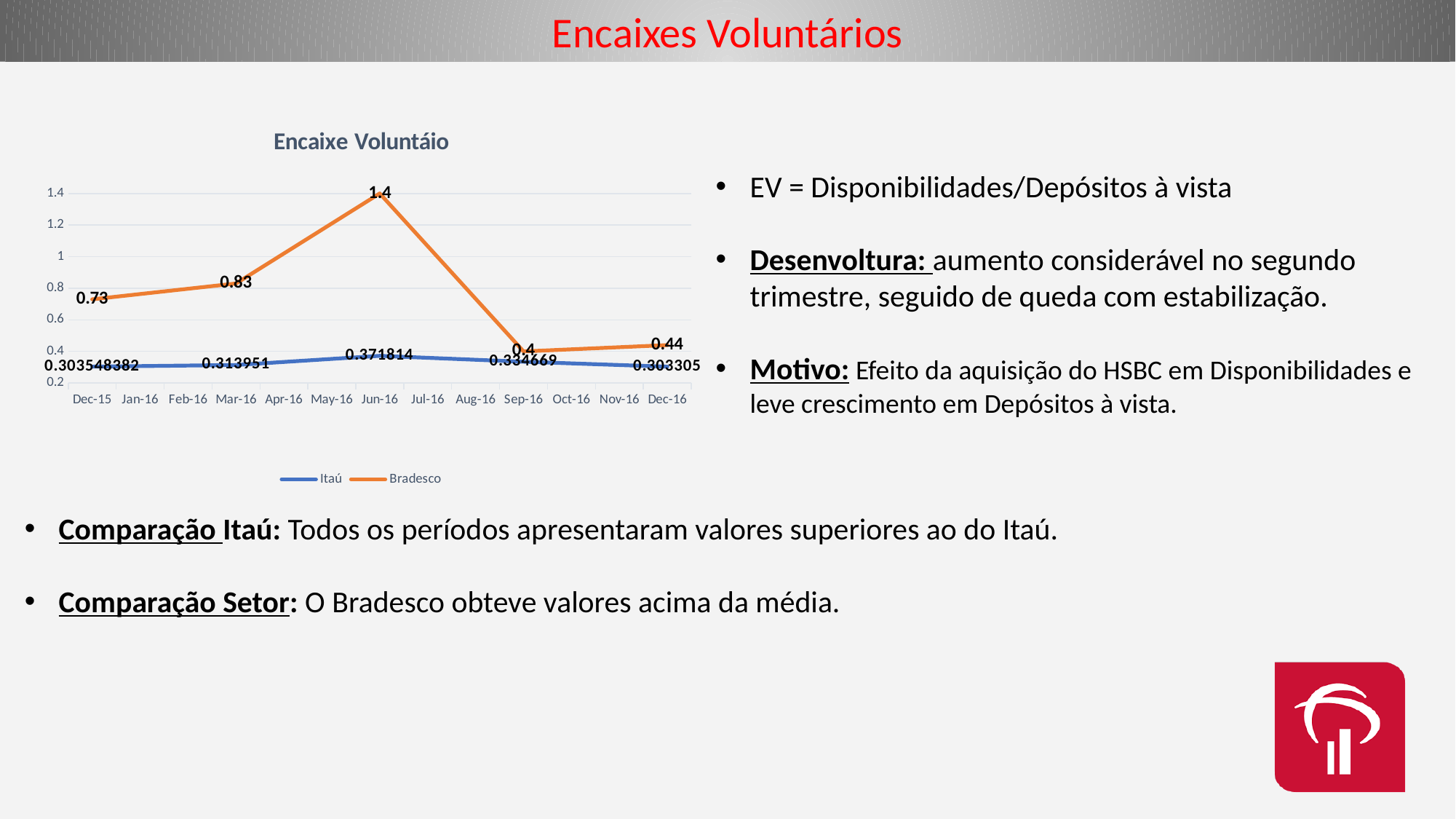
What is the value for Itaú in Jun-16? 0.371814 What is the title of the chart? Encaixe Voluntáio In which month does Bradesco reach its highest value? Jun-16 What is the value for Bradesco in Jun-16? 1.4 In which month does Bradesco have its lowest value? Sep-16 Which is larger for Bradesco: the value in Dec-15 or the value in Dec-16? Dec-15 How many series does the legend of the chart list? 2 What type of chart is shown on the slide? line chart In which month does Itaú reach its highest value? Jun-16 What is the value for Itaú in Dec-15? 0.303548382 What is the value for Bradesco in Dec-16? 0.44 What is the difference between Bradesco's value in Jun-16 and its value in Sep-16? 1